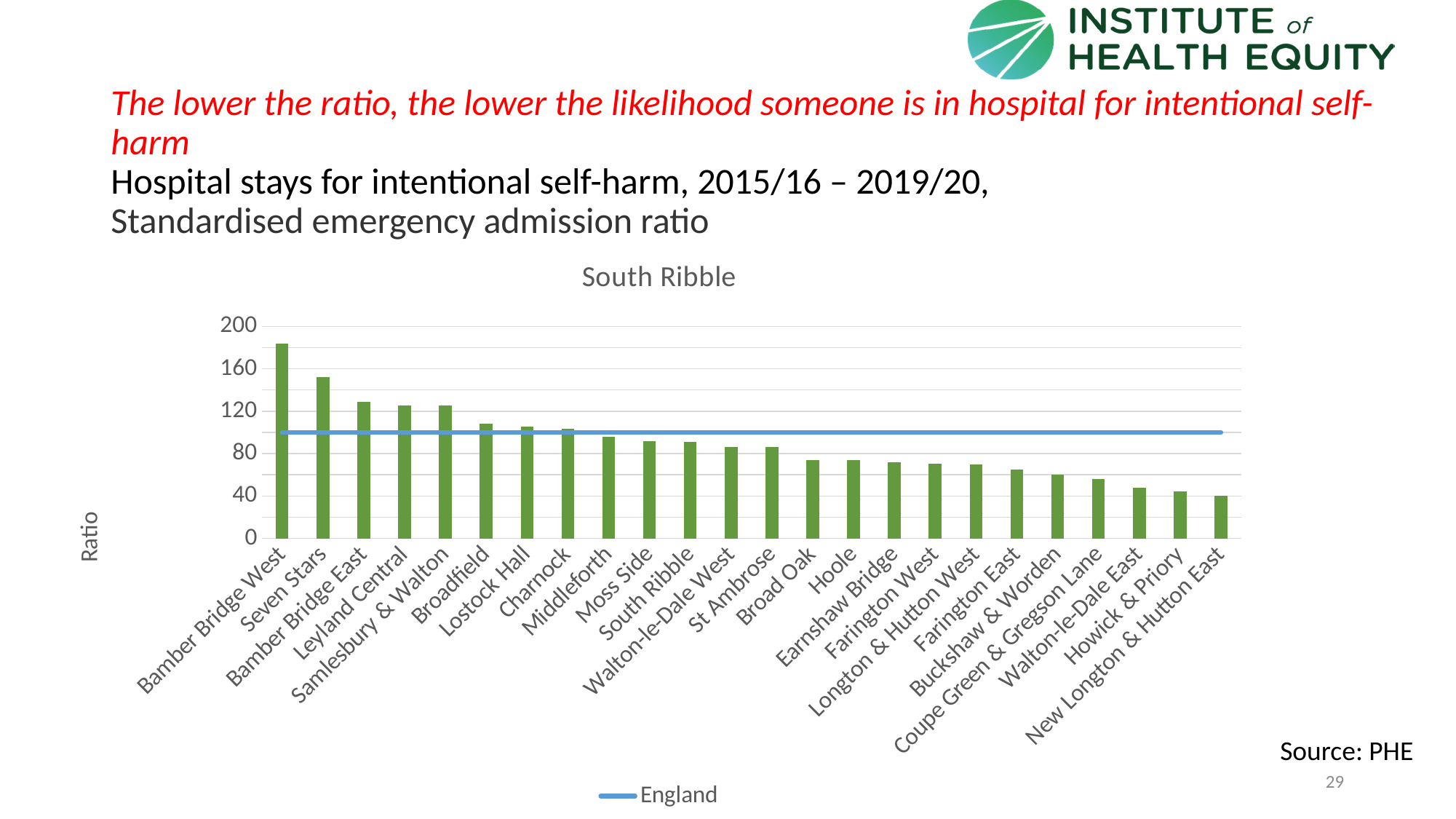
How many series does the legend list? 1 Do the bar values rise or fall moving from left to right along the x axis? Fall Is the value for Broad Oak greater or less than 80? less What kind of chart is shown on the slide? Bar chart Which has a higher ratio, Seven Stars or Bamber Bridge East? Seven Stars What does the horizontal blue line in the chart represent? England How many areas (bars) are plotted in the chart? 24 What is the title of the chart? South Ribble Which area has the lowest standardised emergency admission ratio? New Longton & Hutton East Is the value for Bamber Bridge West greater or less than 160? greater Is the value for Seven Stars greater or less than 160? less Which area has the highest standardised emergency admission ratio? Bamber Bridge West